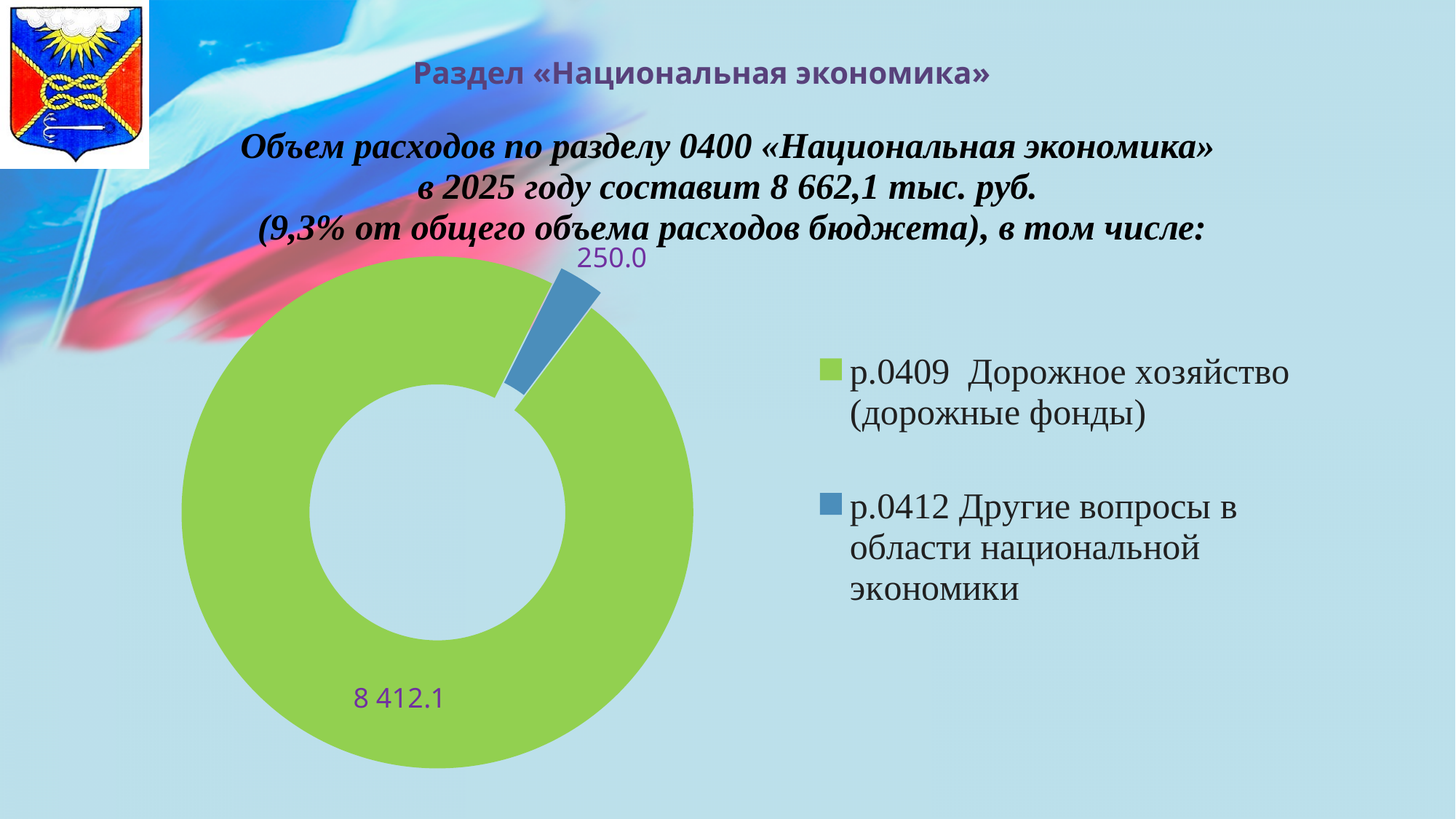
How many entries does the legend list? 2 What kind of chart is shown on the slide? doughnut chart What is the value shown for р.0409 Дорожное хозяйство (дорожные фонды)? 8 412.1 How many categories are shown in the chart? 2 Which category has the largest slice in the chart? р.0409 Дорожное хозяйство (дорожные фонды) What colour is the slice for р.0409 Дорожное хозяйство (дорожные фонды)? green What colour is the slice for р.0412 Другие вопросы в области национальной экономики? blue Which is larger: the value for р.0409 Дорожное хозяйство or the value for р.0412 Другие вопросы в области национальной экономики? р.0409 Дорожное хозяйство Which category has the smallest slice in the chart? р.0412 Другие вопросы в области национальной экономики What is the total of the two values shown in the chart? 8 662.1 What is the difference between the values for р.0409 Дорожное хозяйство and р.0412 Другие вопросы в области национальной экономики? 8 162.1 What is the value shown for р.0412 Другие вопросы в области национальной экономики? 250.0